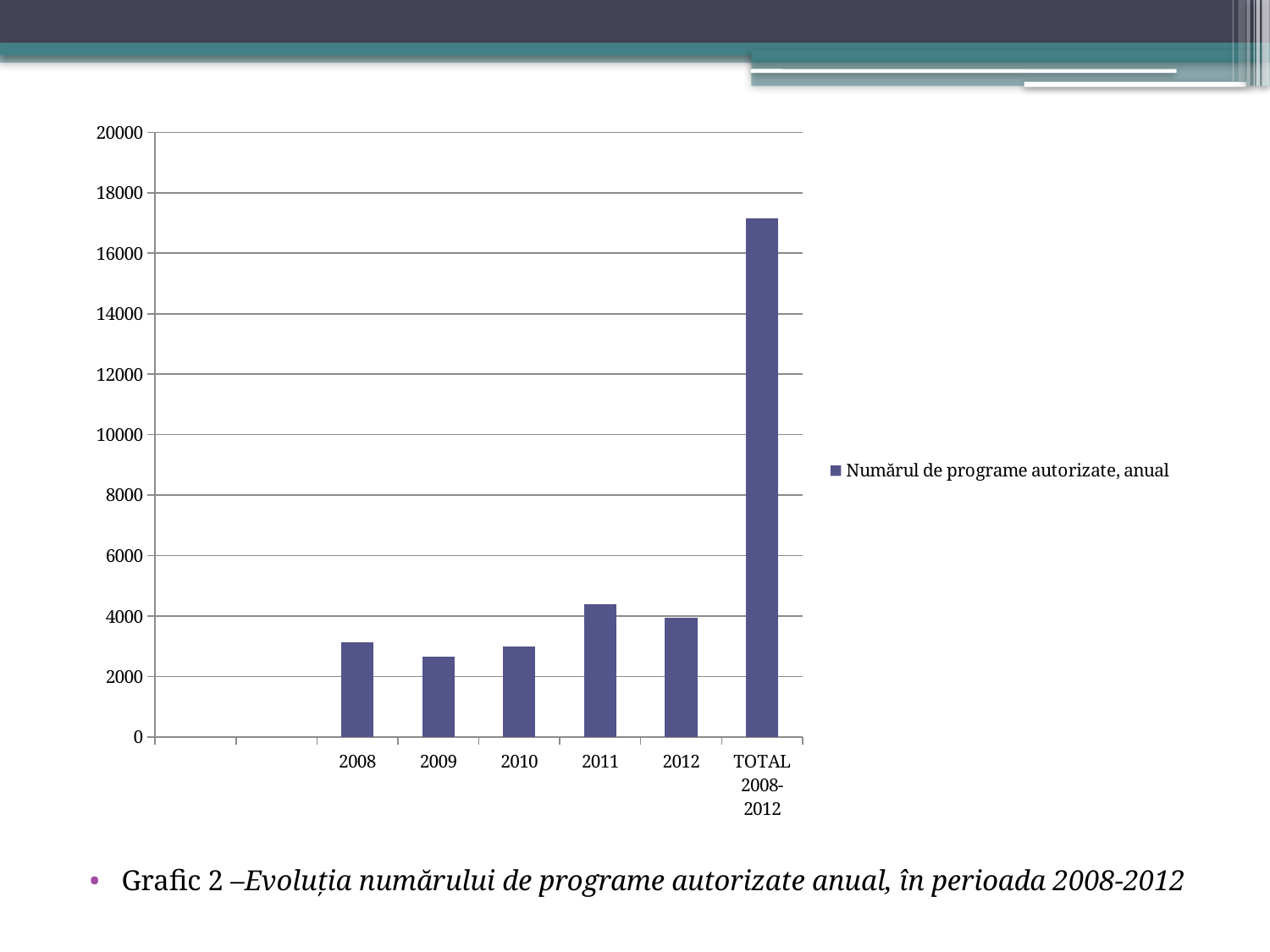
How many categories are shown on the x axis of the chart? 6 Which is larger, the value for 2011 or the value for 2012? 2011 How many series does the chart's legend list? 1 Is the value for TOTAL 2008-2012 greater or less than 16000? greater Is the value for 2009 greater or less than 4000? less What kind of chart is shown on the slide? bar chart Is the value for 2008 greater or less than 2000? greater What is the series name shown in the chart's legend? Numărul de programe autorizate, anual Which year has the lowest bar in the chart? 2009 Which category has the highest bar in the chart? TOTAL 2008-2012 What is the caption given below the chart? Grafic 2 – Evoluția numărului de programe autorizate anual, în perioada 2008-2012 Which is larger, the value for 2008 or the value for 2009? 2008